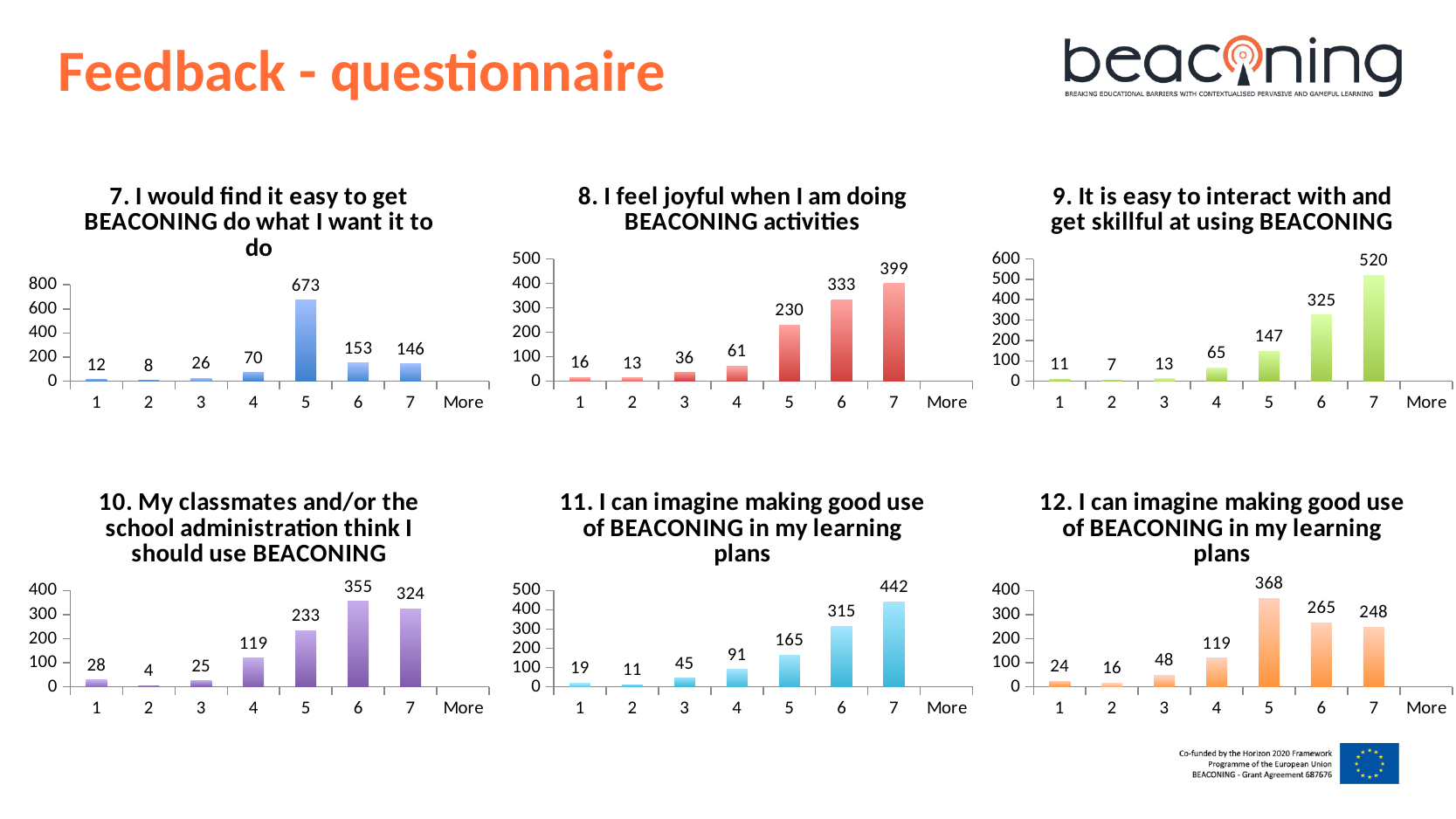
In the chart titled "9. It is easy to interact with and get skillful at using BEACONING", what is the difference between the values for category 7 and category 6? 195 In the chart titled "10. My classmates and/or the school administration think I should use BEACONING", which category has the lowest value? 2 In the chart titled "8. I feel joyful when I am doing BEACONING activities", what is the value for category 4? 61 In the chart titled "9. It is easy to interact with and get skillful at using BEACONING", what is the value for category 7? 520 In the chart titled "10. My classmates and/or the school administration think I should use BEACONING", which is larger, the value for category 6 or category 7? 6 In the chart titled "12. I can imagine making good use of BEACONING in my learning plans", which category has the highest value? 5 How many charts are shown on the slide? 6 In the chart titled "8. I feel joyful when I am doing BEACONING activities", which category has the highest value? 7 In the chart titled "11. I can imagine making good use of BEACONING in my learning plans", what is the difference between the values for category 7 and category 6? 127 What kind of chart is the chart titled "12. I can imagine making good use of BEACONING in my learning plans"? Bar chart How many categories are shown on the x axis of the chart titled "7. I would find it easy to get BEACONING do what I want it to do"? 8 In the chart titled "7. I would find it easy to get BEACONING do what I want it to do", what is the value for category 5? 673